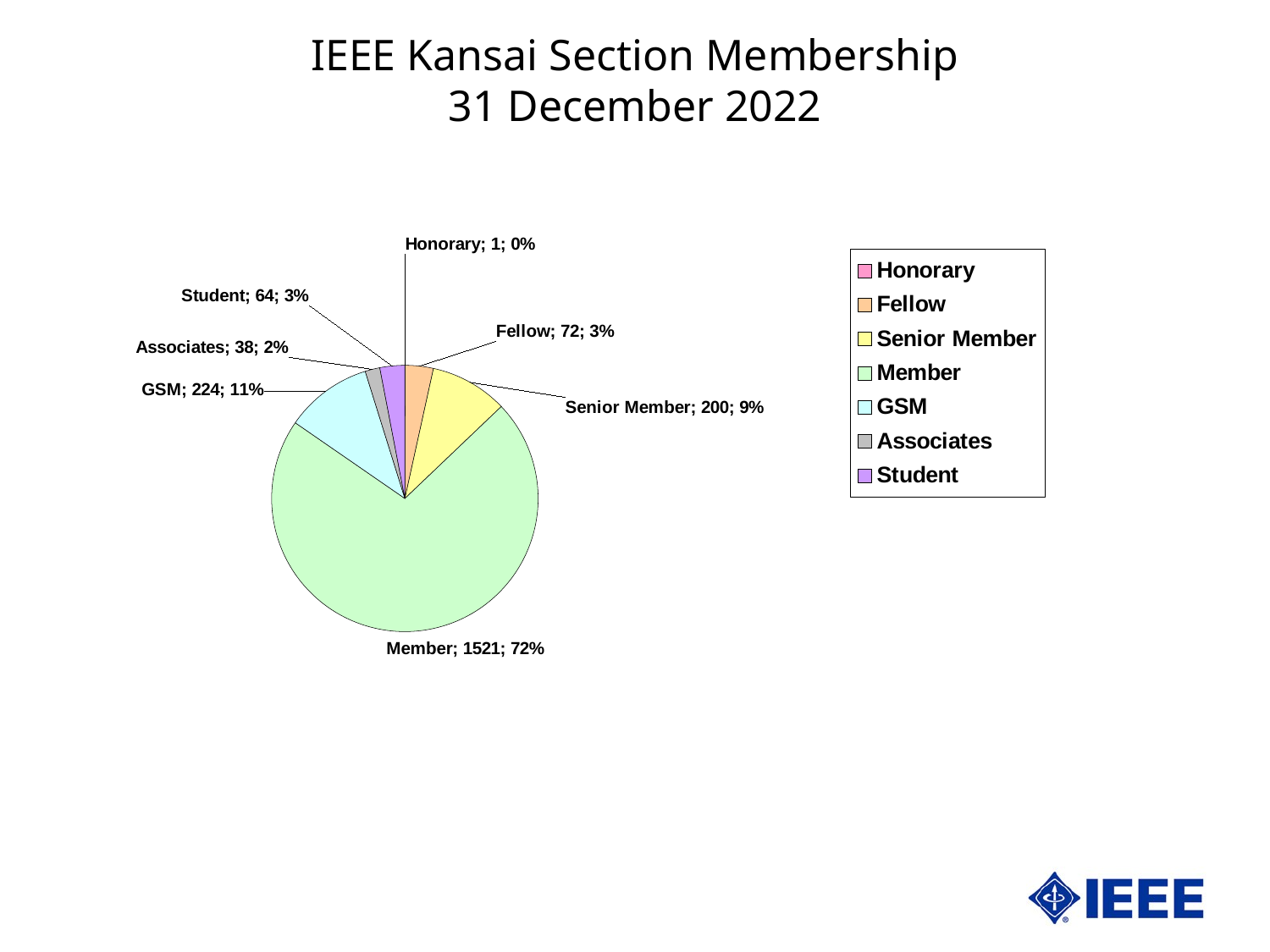
How many members are in the Member category? 1521 What is the title of the chart on the slide? IEEE Kansai Section Membership 31 December 2022 Which category has the smallest slice? Honorary Which category has the largest slice? Member What is the value for GSM? 224 What share of the pie does the Member slice represent? 72% Which is larger, the value for Fellow or the value for Student? Fellow What is the value for Senior Member? 200 What is the difference between the GSM value and the Senior Member value? 24 How many categories does the pie chart have? 7 What type of chart is shown on the slide? pie chart What share of the pie does GSM represent? 11%